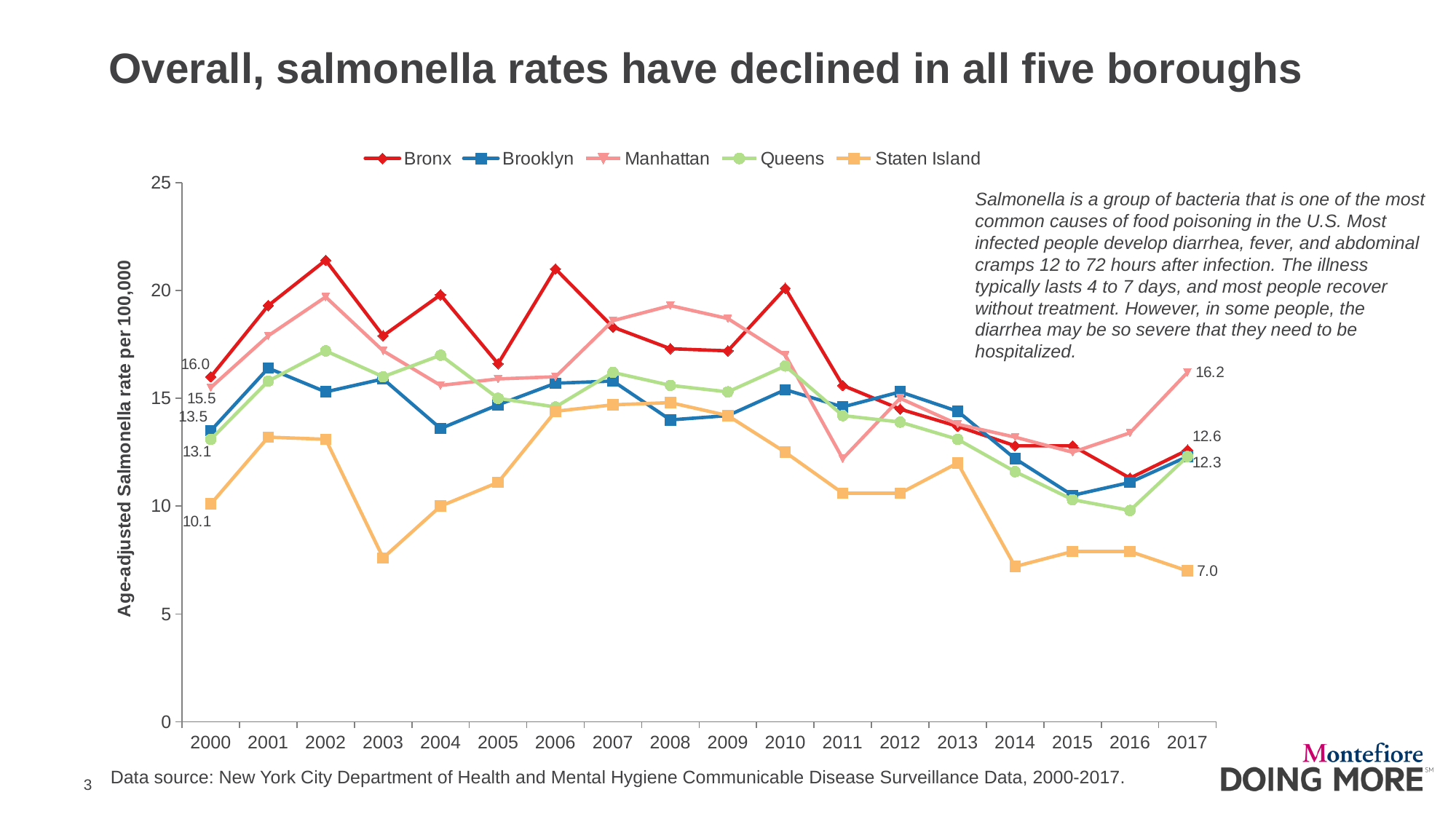
Is the value for the Bronx in 2002 greater or less than 20? greater Which had the higher rate in 2000, the Bronx or Manhattan? Bronx By how much did the Staten Island rate fall from 2000 to 2017? 3.1 What was the age-adjusted salmonella rate for Staten Island in 2017? 7.0 Which borough had the lowest salmonella rate in 2017? Staten Island How many years are shown on the x axis? 18 What was the age-adjusted salmonella rate for Staten Island in 2000? 10.1 How many series does the legend list? 5 Which borough had the highest salmonella rate in 2017? Manhattan What was the age-adjusted salmonella rate for the Bronx in 2000? 16.0 What was the age-adjusted salmonella rate for Manhattan in 2017? 16.2 What kind of chart is shown on the slide? line chart